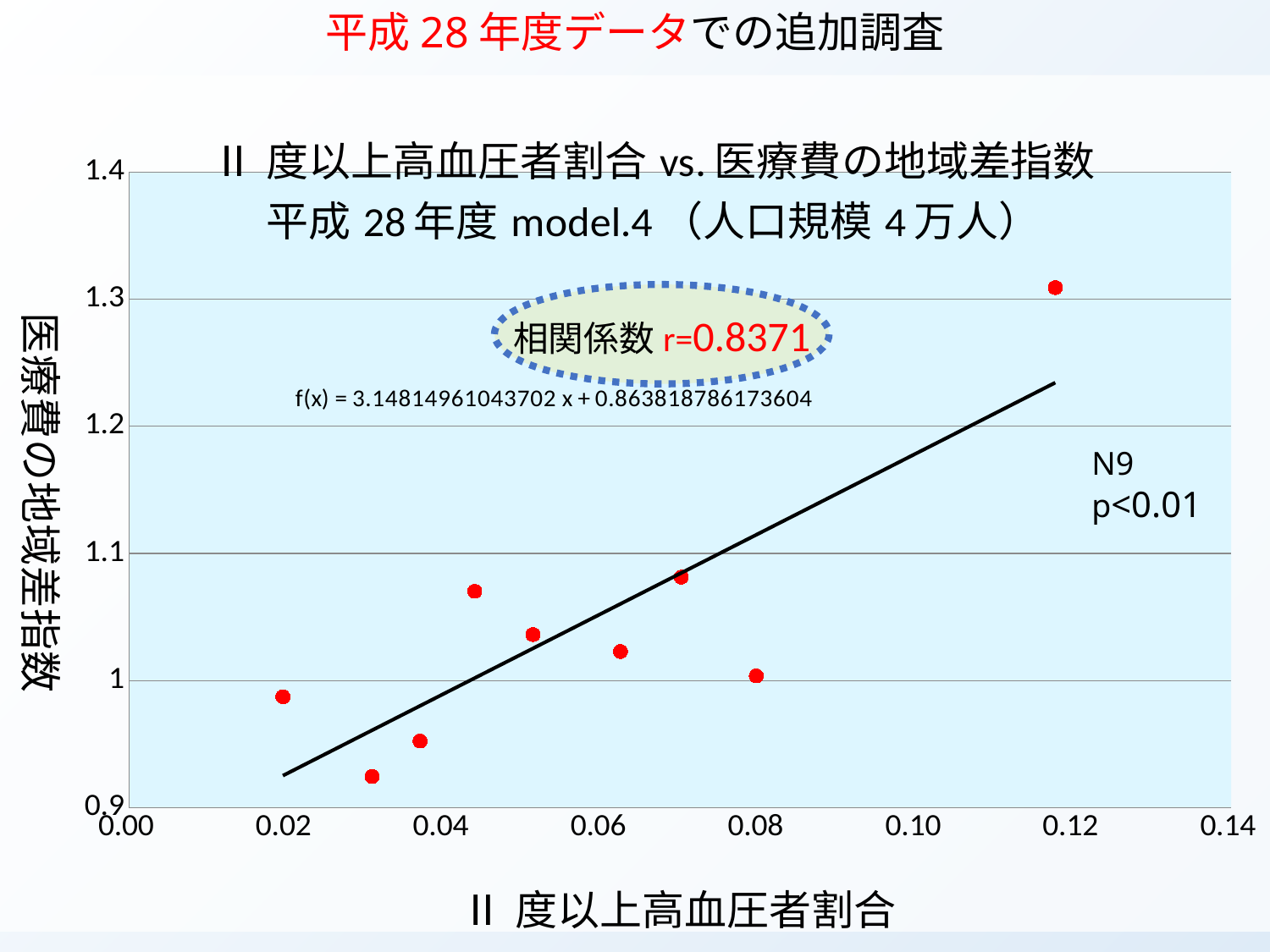
Is the y value of the data point at about 0.08 on the x axis greater or less than 1.1? less Which data point has the lowest y value: the one at about 0.03 on the x axis or the one at about 0.02? the one at about 0.03 What p-value is stated on the chart? p<0.01 Is the y value of the data point at about 0.03 on the x axis greater or less than 1? less Which data point has the highest 医療費の地域差指数 value: the one at about 0.12 on the x axis or the one at about 0.07? the one at about 0.12 Is the y value of the data point at about 0.12 on the x axis greater or less than 1.2? greater What is the maximum value shown on the y axis? 1.4 What kind of chart is shown on the slide? scatter plot What is the correlation coefficient (相関係数) shown on the chart? r=0.8371 How many data points are plotted in the chart? 9 Do the plotted values generally rise or fall as the x-axis value (Ⅱ度以上高血圧者割合) increases? rise